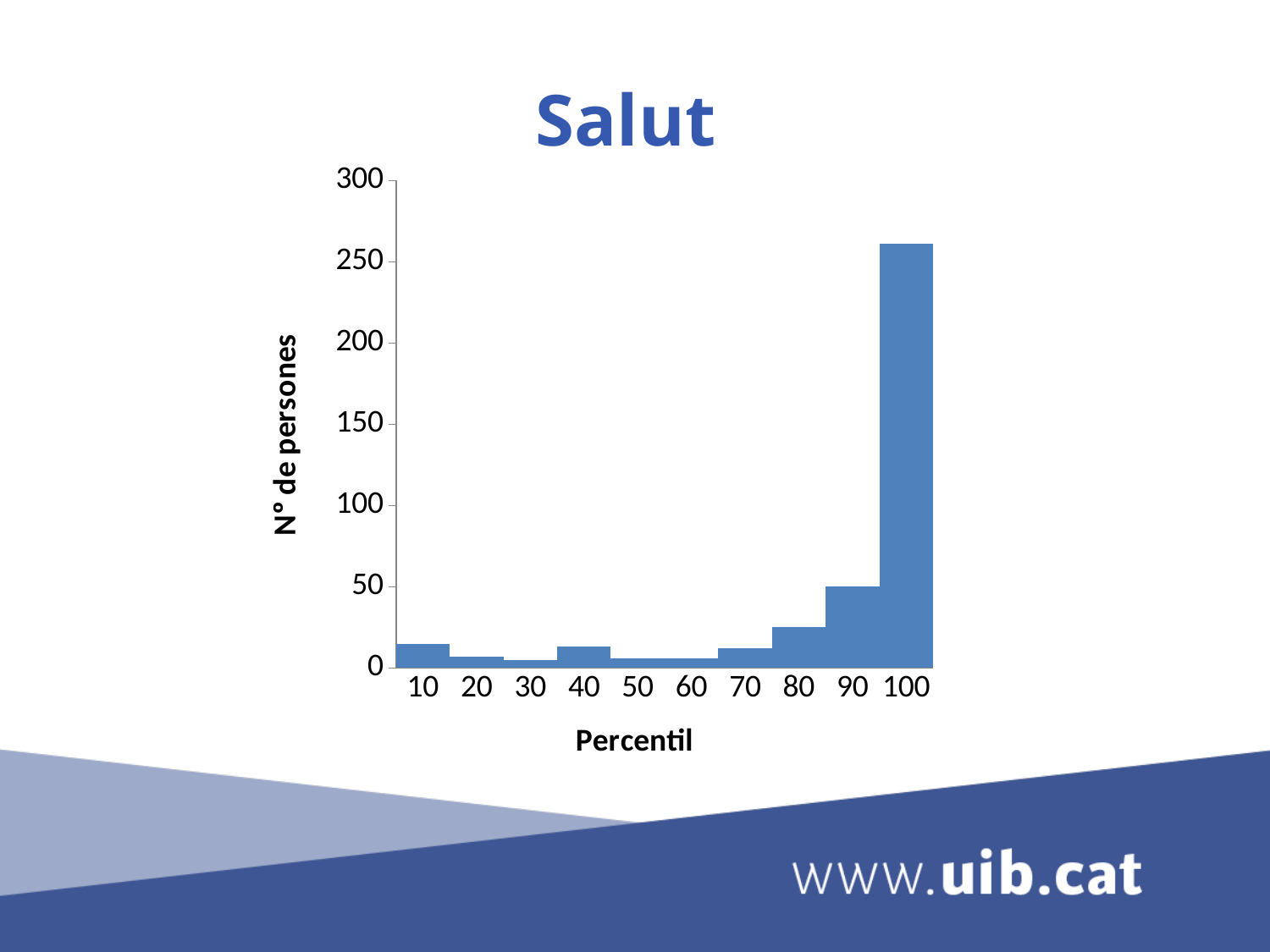
Which has a higher value, percentile 10 or percentile 80? 80 How many percentile categories are shown on the x axis? 10 Which has a higher value, percentile 90 or percentile 100? 100 Which percentile category has the highest number of people? 100 What is the label of the x axis? Percentil Do the values rise or fall from percentile 70 to percentile 100? rise Is the value for percentile 100 greater or less than 250? greater Is the value for percentile 80 greater or less than 50? less Is the value for percentile 30 greater or less than 50? less What is the title of the chart? Salut What type of chart is shown on the slide? bar chart